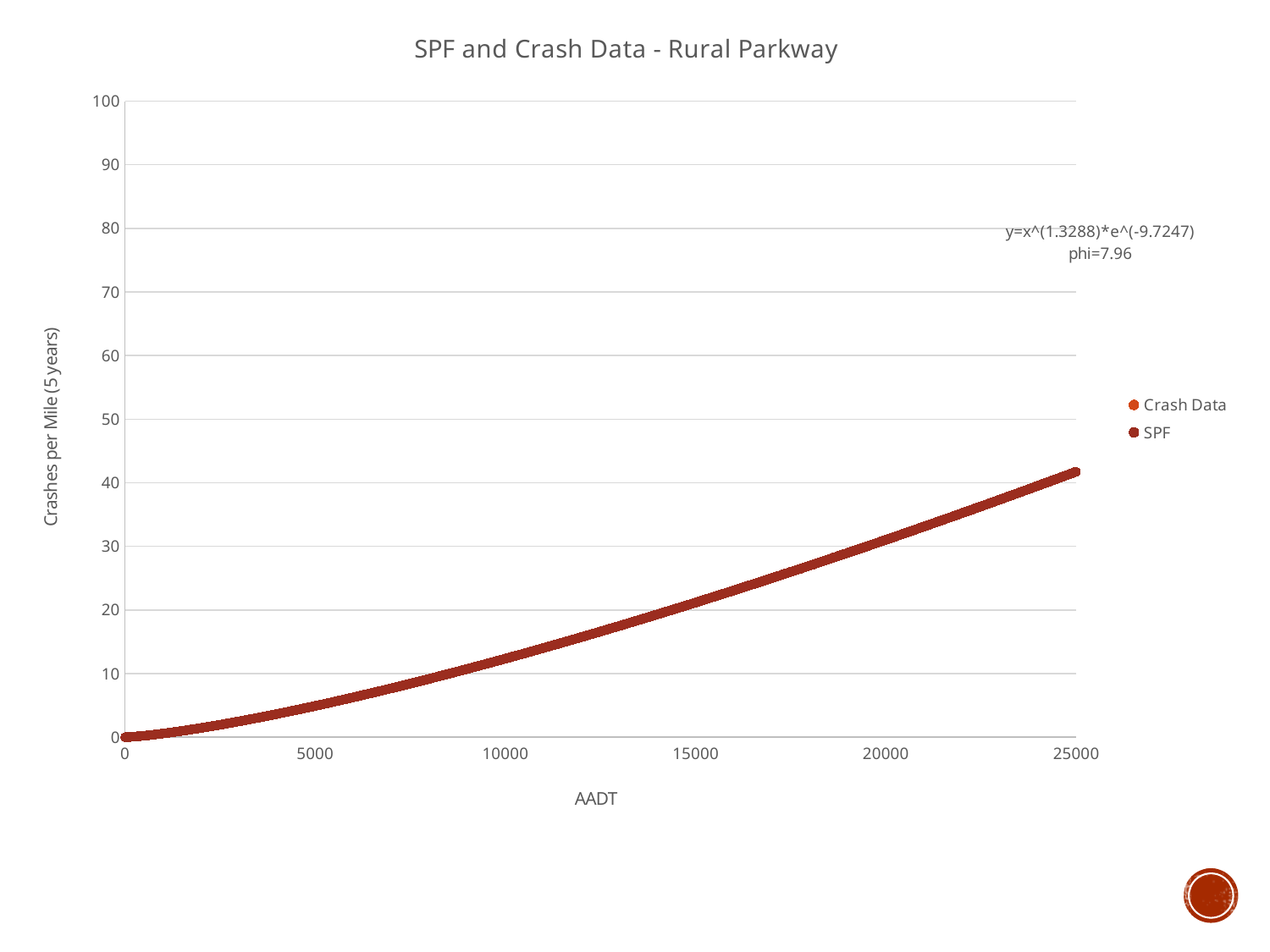
Is the SPF value at an AADT of 10000 greater or less than 10? greater Do the SPF values rise or fall as AADT increases along the x axis? rise Is the SPF value at an AADT of 25000 greater or less than 50? less What is the title of the chart? SPF and Crash Data - Rural Parkway What are the two series named in the legend? Crash Data and SPF What is the label of the y axis? Crashes per Mile (5 years) Is the SPF value at an AADT of 5000 greater or less than 10? less What kind of chart is shown on the slide? scatter chart What value of phi is printed on the chart? 7.96 How many series does the chart's legend list? 2